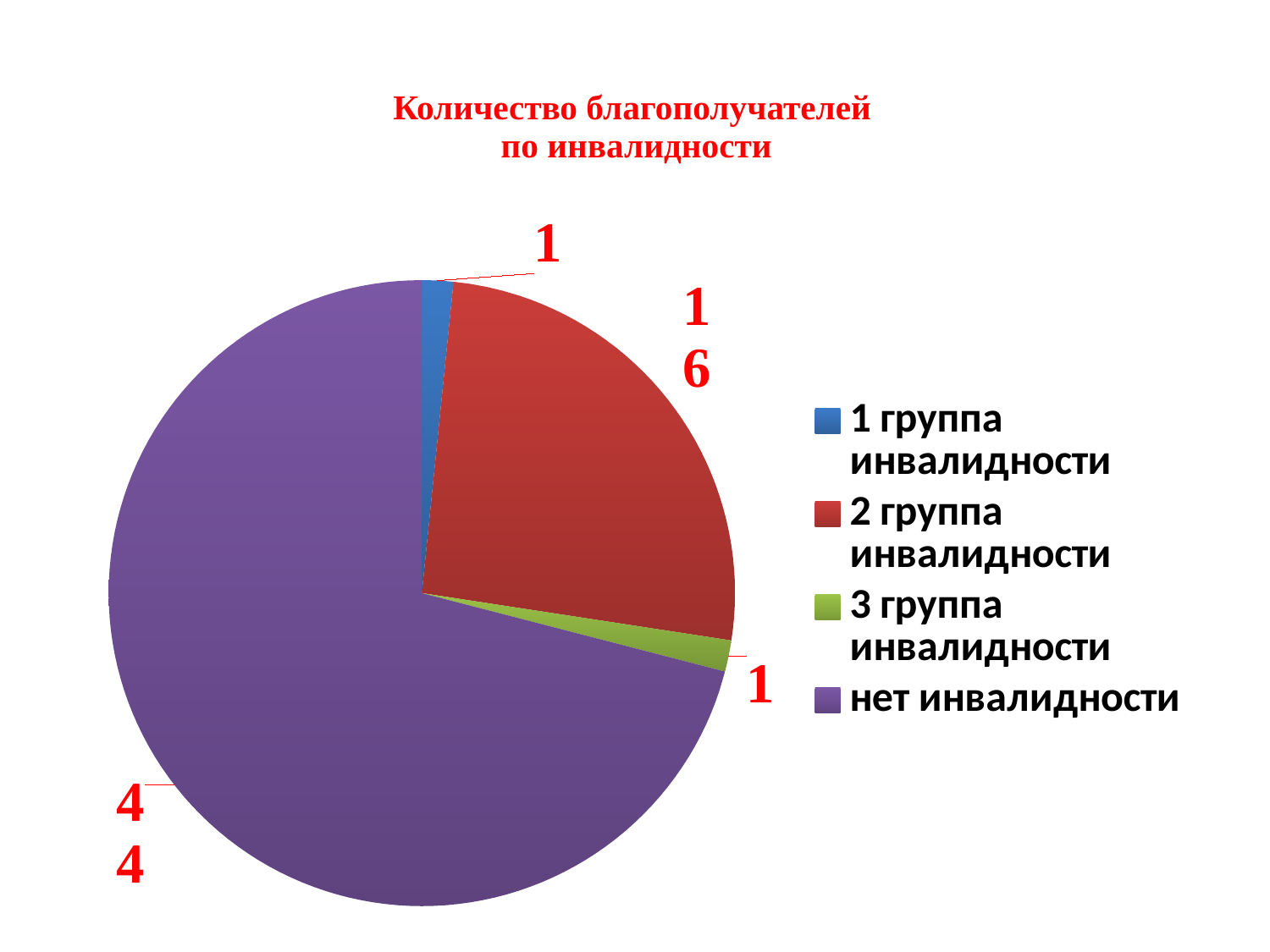
What is the value for "нет инвалидности"? 44 How many entries does the legend list? 4 What is the title of the chart? Количество благополучателей по инвалидности What is the value for "1 группа инвалидности"? 1 How many slices does the pie chart have? 4 What is the difference between the values for "нет инвалидности" and "2 группа инвалидности"? 28 What is the value for "2 группа инвалидности"? 16 What is the value for "3 группа инвалидности"? 1 What colour is the slice for "2 группа инвалидности"? red Which is larger: "2 группа инвалидности" or "нет инвалидности"? нет инвалидности What kind of chart is shown on the slide? pie chart Which category has the largest slice of the pie? нет инвалидности